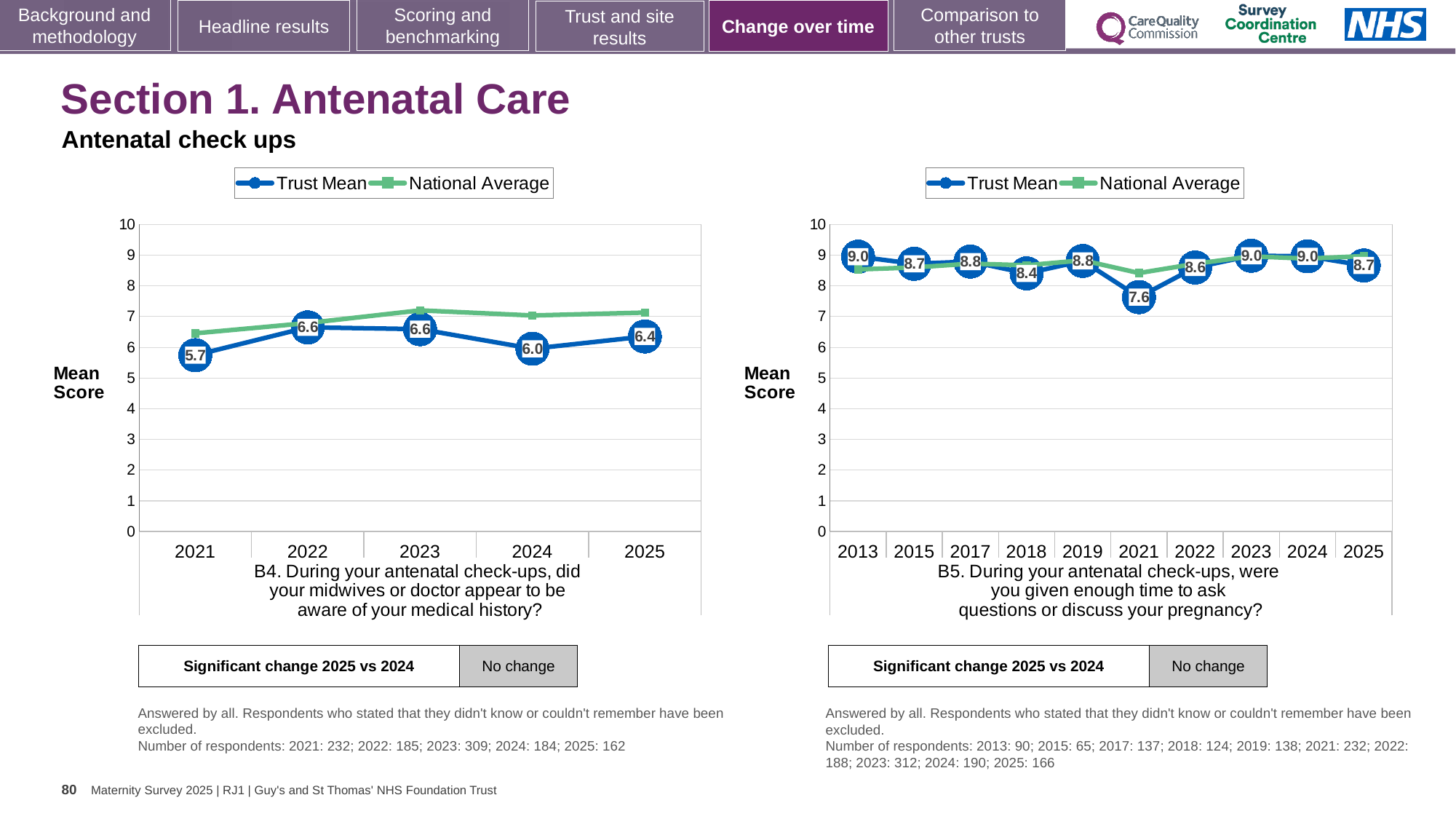
In the B4 chart (left), what is the Trust Mean for 2024? 6.0 In the B4 chart (left), which year has the lowest Trust Mean? 2021 In the B4 chart (left), how many years are shown on the x axis? 5 In the B4 chart (left), is the National Average for 2021 greater or less than 6? greater In the B5 chart (right), is the Trust Mean higher in 2019 or in 2022? 2019 In the B5 chart (right), what is the Trust Mean for 2018? 8.4 What type of chart is the B5 chart (right)? Line chart In the B5 chart (right), how many series does the legend list? 2 In the B5 chart (right), which year has the lowest Trust Mean? 2021 In the B4 chart (left), what is the difference between the Trust Mean in 2025 and in 2021? 0.7 In the B5 chart (right), what is the Trust Mean for 2021? 7.6 In the B4 chart (left), what is the Trust Mean for 2021? 5.7